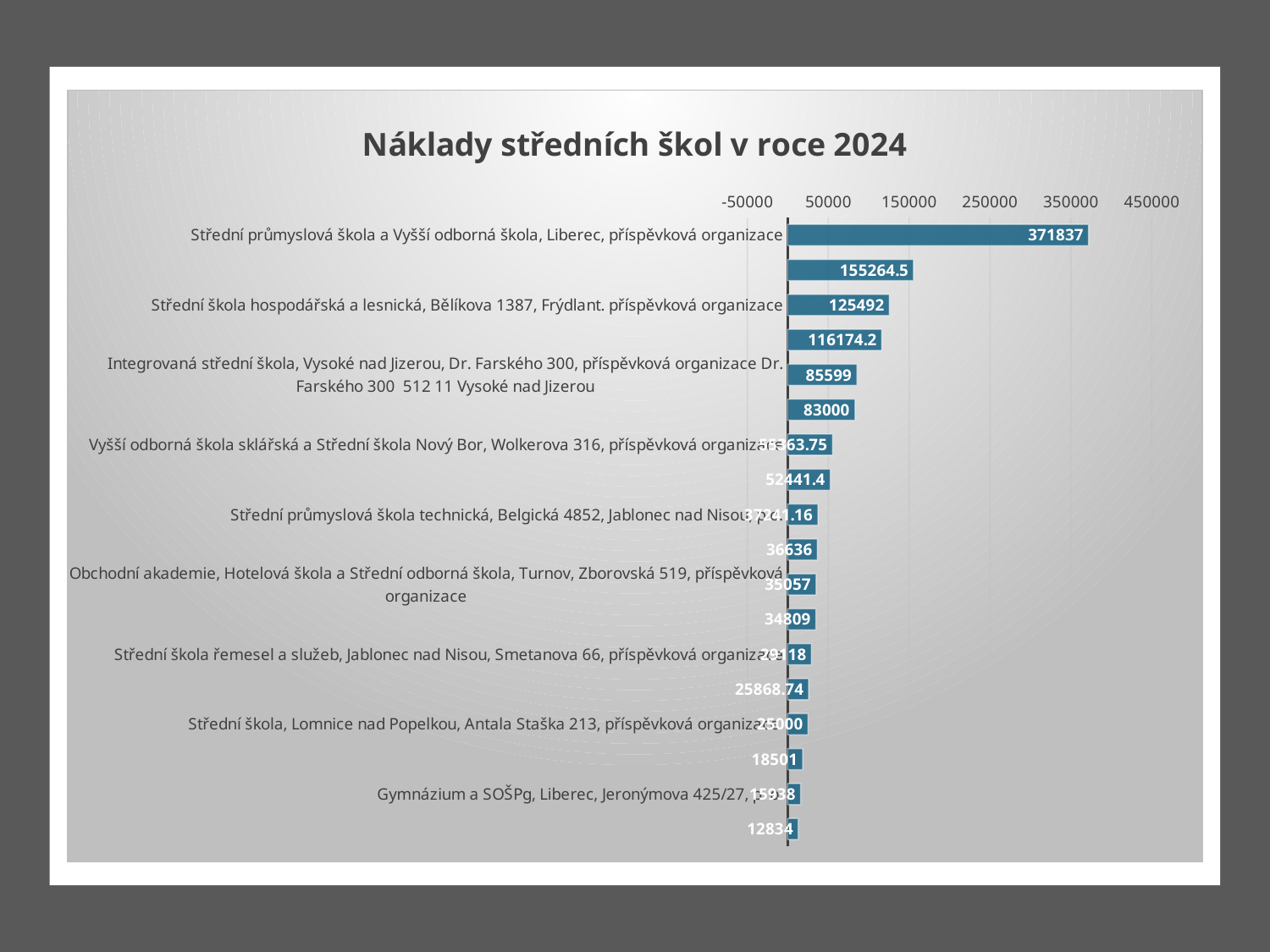
Which has the larger value: Střední škola hospodářská a lesnická, Frýdlant or Obchodní akademie, Hotelová škola a Střední odborná škola, Turnov? Střední škola hospodářská a lesnická, Frýdlant What is the value for Střední průmyslová škola a Vyšší odborná škola, Liberec, příspěvková organizace? 371837 What is the value for Obchodní akademie, Hotelová škola a Střední odborná škola, Turnov, Zborovská 519, příspěvková organizace? 35057 What kind of chart is shown on the slide? bar chart Do the bar values increase or decrease going from the top of the chart to the bottom? decrease What is the title of the chart? Náklady středních škol v roce 2024 Which school has the highest value in the chart? Střední průmyslová škola a Vyšší odborná škola, Liberec, příspěvková organizace What is the difference between the values for Střední průmyslová škola a Vyšší odborná škola, Liberec and Střední škola hospodářská a lesnická, Frýdlant? 246345 What is the value for Střední škola, Lomnice nad Popelkou, Antala Staška 213, příspěvková organizace? 25000 How many bars are plotted in the chart? 18 What is the value for Integrovaná střední škola, Vysoké nad Jizerou, Dr. Farského 300, příspěvková organizace? 85599 What is the value for Střední škola hospodářská a lesnická, Bělíkova 1387, Frýdlant. příspěvková organizace? 125492